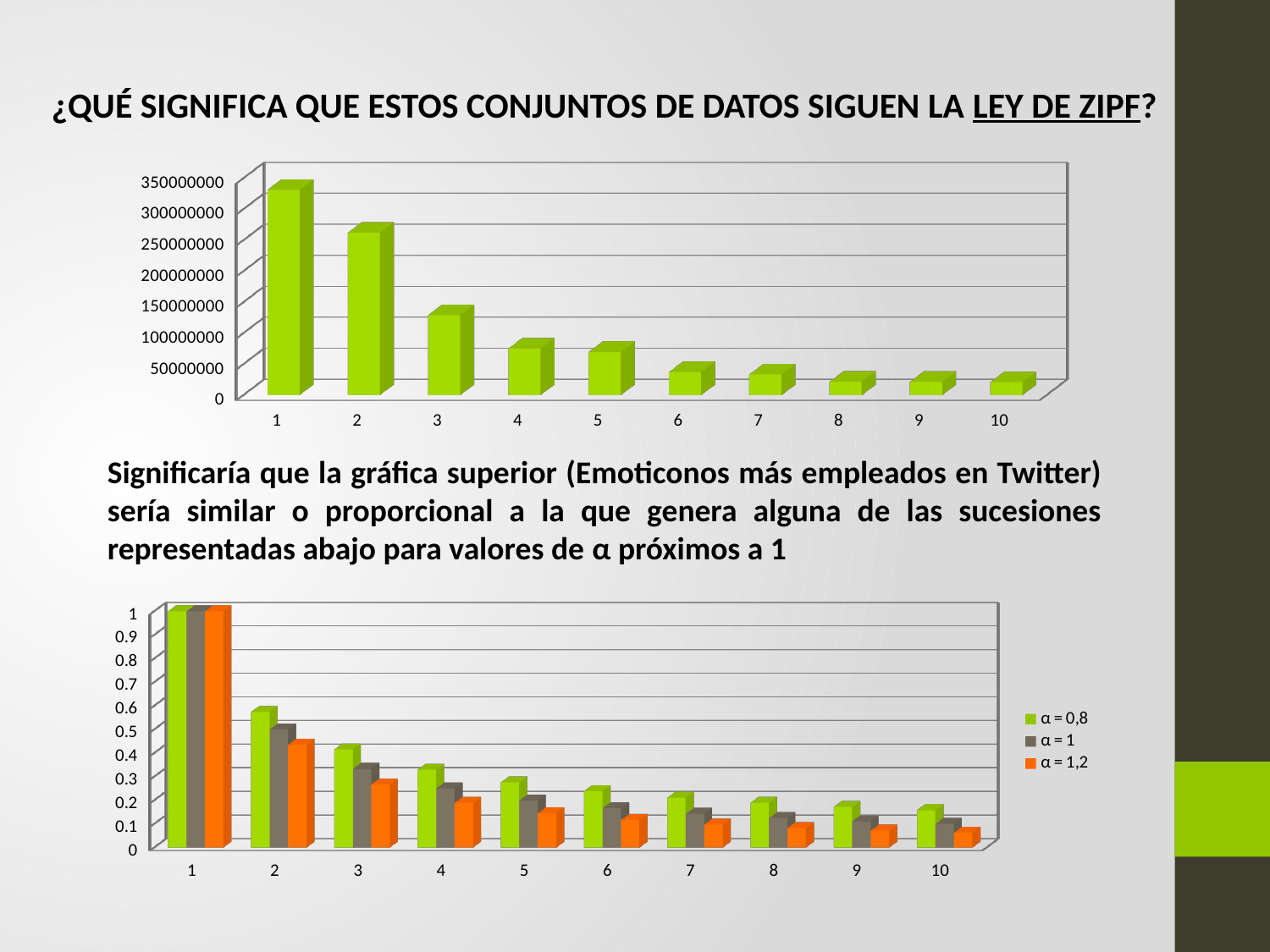
In the bottom chart, is the value of the α = 1,2 series at category 10 greater or less than 0.1? less What are the legend entries of the bottom chart? α = 0,8, α = 1, α = 1,2 What kind of chart is the top chart on the slide? bar chart In the top chart, which is larger, the value for category 2 or the value for category 4? 2 In the bottom chart, what is the value of the α = 1 series at category 1? 1 How many categories are shown on the x axis of the top chart? 10 In the top chart, which category has the highest bar? 1 In the top chart, do the values rise or fall as you move from category 1 to category 10? fall How many series does the legend of the bottom chart list? 3 In the top chart, is the value for category 3 greater or less than 150000000? less In the top chart, is the value for category 1 greater or less than 300000000? greater In the bottom chart, at category 2, which series has the larger value, α = 0,8 or α = 1,2? α = 0,8